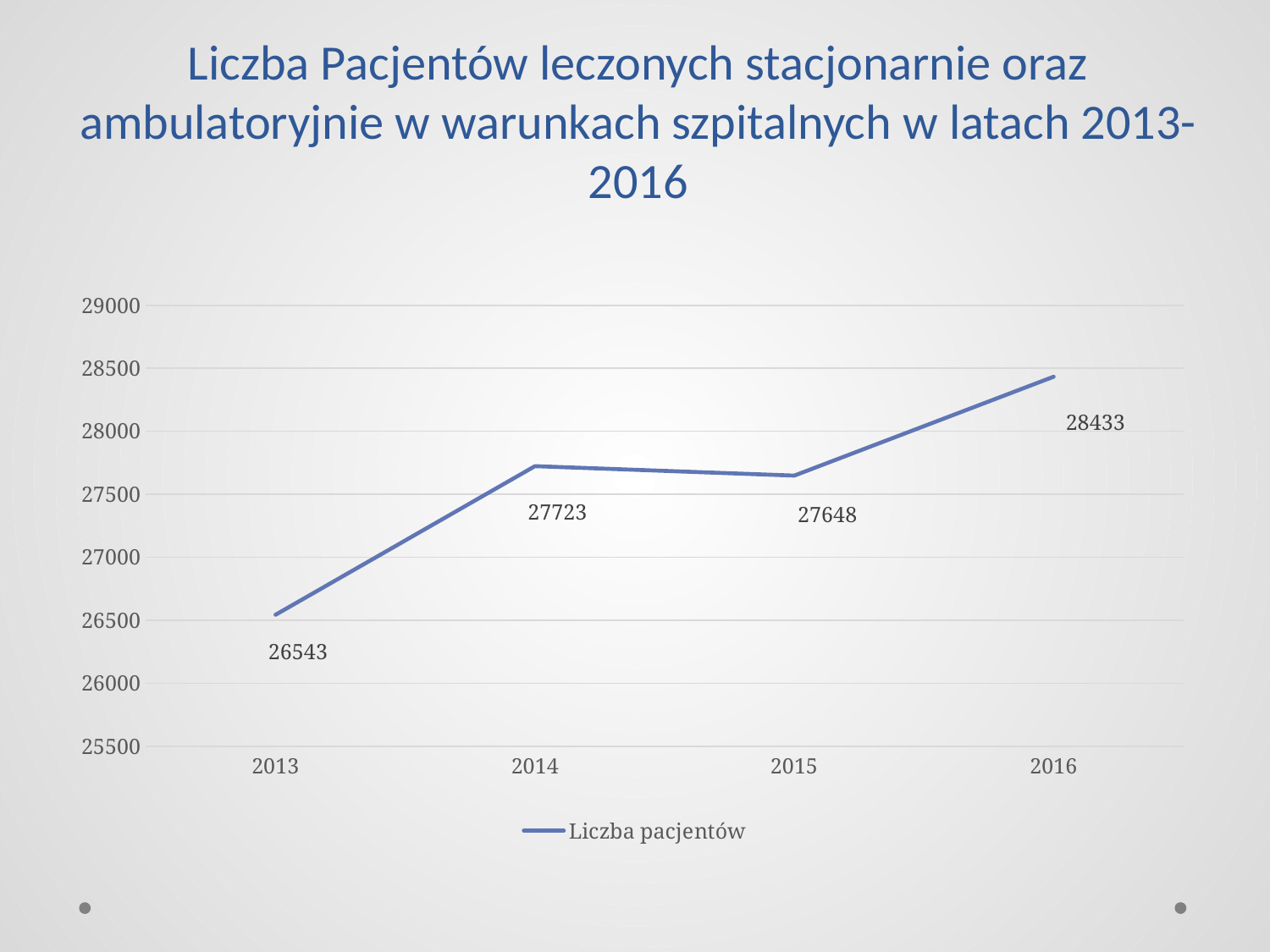
Which year had the highest number of patients? 2016 What is the name of the series in the legend? Liczba pacjentów Is the value for 2016 greater or less than 28000? greater How many series does the legend list? 1 Which year had more patients, 2014 or 2015? 2014 What value is shown for 2015? 27648 Which year had the lowest number of patients? 2013 What is the difference between the number of patients in 2016 and in 2013? 1890 What was the number of patients in 2013? 26543 How many years are plotted on the x axis? 4 What kind of chart is shown on the slide? line chart What was the number of patients in 2016? 28433